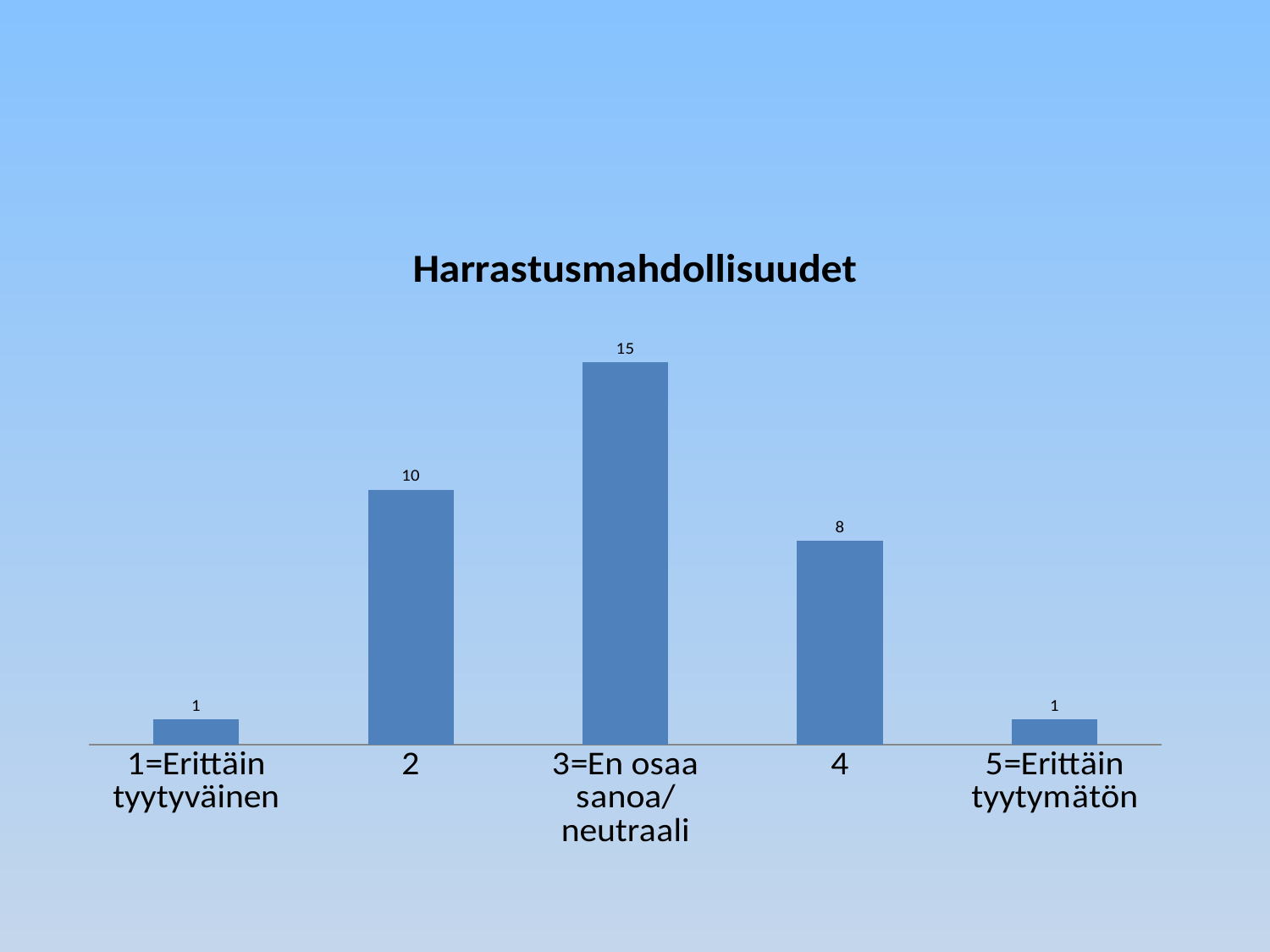
What is the value for "3=En osaa sanoa/neutraali"? 15 What is the title of the chart? Harrastusmahdollisuudet What kind of chart is shown on the slide? Bar chart What is the value for "5=Erittäin tyytymätön"? 1 What is the difference between the values for "3=En osaa sanoa/neutraali" and "2"? 5 What is the total of all the values shown in the chart? 35 What is the difference between the values for "2" and "4"? 2 What is the value for the category "4"? 8 What is the value for the category "2"? 10 Which category has the highest value? 3=En osaa sanoa/neutraali Which is larger, the value for "2" or the value for "4"? 2 How many categories are shown on the x axis? 5